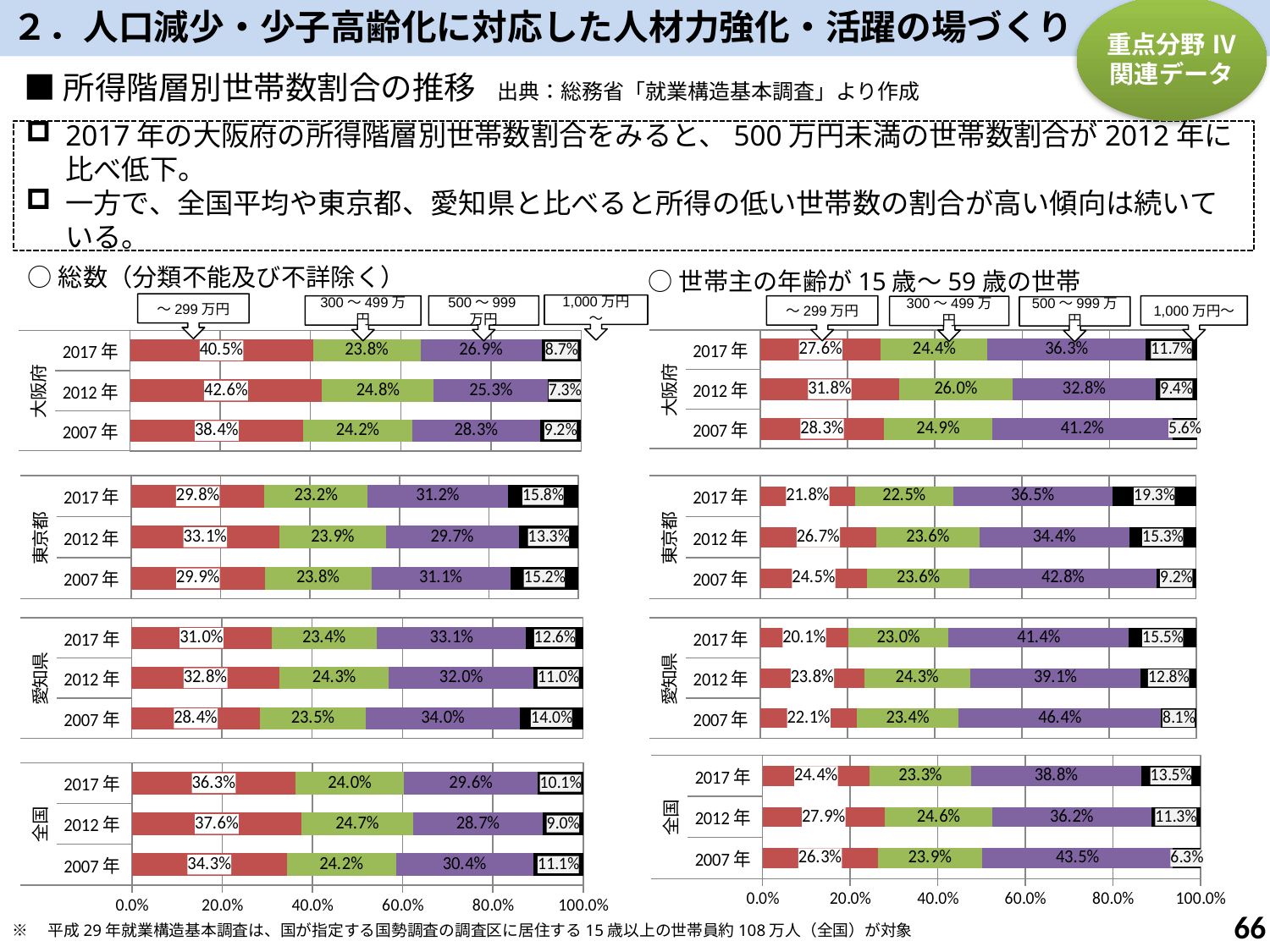
How many series does the legend of the left chart (総数) list? 4 In the left chart (総数), which region has the highest ～299万円 share in 2017年? 大阪府 What kind of chart is the left chart (総数)? Stacked horizontal bar chart In the left chart (総数), how did the 1,000万円～ share for 全国 change from 2007年 to 2017年? It fell from 11.1% to 10.1% In the left chart (総数), what is the share of households with income under 299万円 in 大阪府 in 2017年? 40.5% In the right chart (世帯主の年齢が15歳～59歳の世帯), what is the ～299万円 share for 全国 in 2012年? 27.9% How many bars (region-year combinations) are plotted in the right chart (世帯主の年齢が15歳～59歳の世帯)? 12 In the right chart (世帯主の年齢が15歳～59歳の世帯), which is larger: the 1,000万円～ share for 東京都 in 2017年 or for 大阪府 in 2017年? 東京都 (19.3%) In the right chart (世帯主の年齢が15歳～59歳の世帯), which region has the lowest ～299万円 share in 2017年? 愛知県 In the right chart (世帯主の年齢が15歳～59歳の世帯), what is the share of the 500～999万円 segment for 愛知県 in 2007年? 46.4% In the left chart (総数), by how many percentage points did the ～299万円 share for 大阪府 fall from 2012年 to 2017年? 2.1 percentage points In the left chart (総数), what is the 1,000万円～ share for 東京都 in 2017年? 15.8%